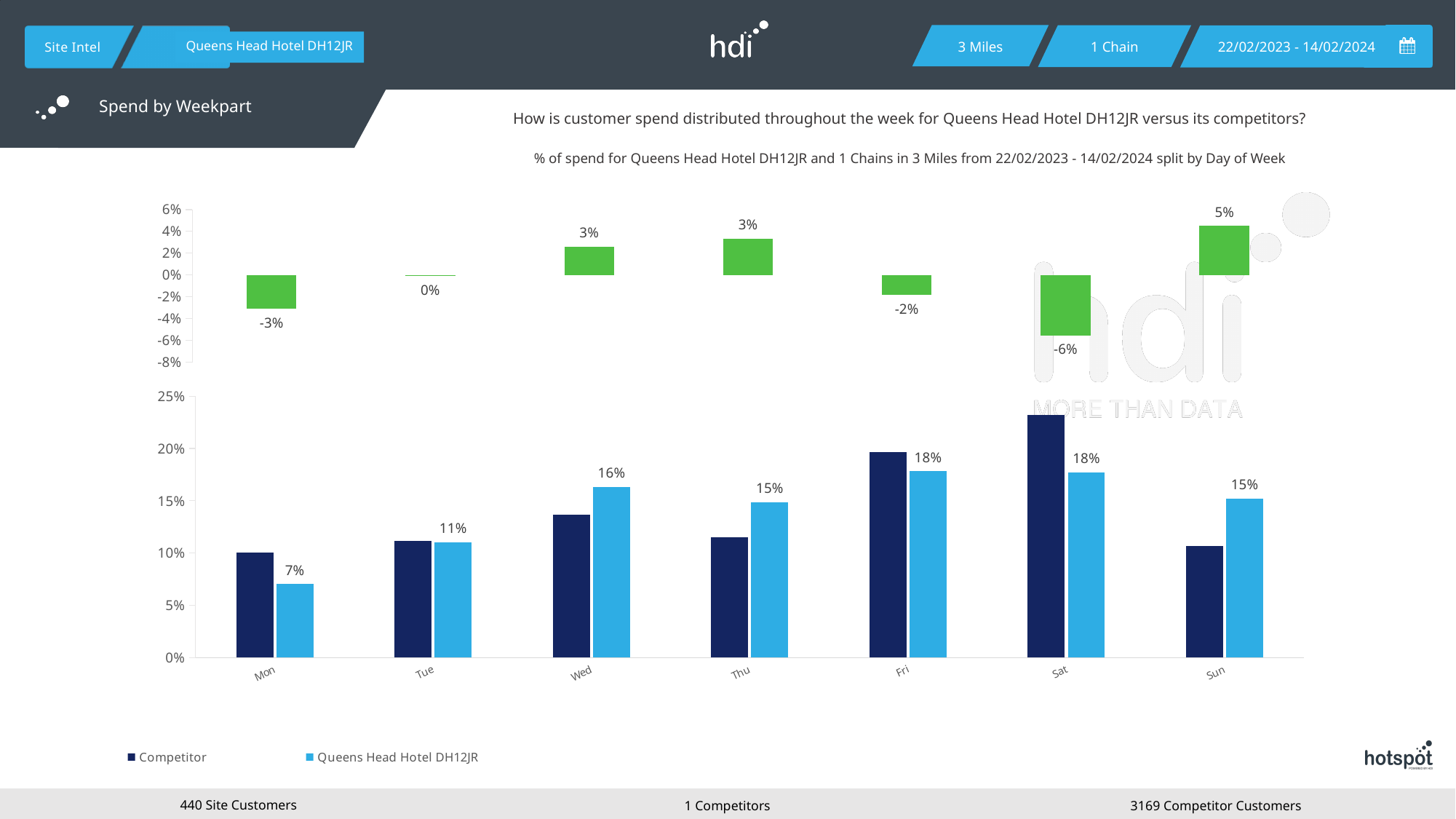
In the top chart, which day has the lowest value? Sat In the top chart, what is the value shown for Sun? 5% In the bottom chart, what is the difference between the Queens Head Hotel DH12JR values for Fri and Mon? 11% In the bottom chart, what is the value for Queens Head Hotel DH12JR on Wed? 16% In the bottom chart, what is the value for Queens Head Hotel DH12JR on Mon? 7% In the bottom chart, which is larger on Sat: the Competitor value or the Queens Head Hotel DH12JR value? Competitor In the top chart, what is the value shown for Sat? -6% In the bottom chart, is the Competitor value for Sat greater or less than 20%? greater In the bottom chart, which day has the lowest value for Queens Head Hotel DH12JR? Mon How many days are shown on the x axis of the bottom chart? 7 In the top chart, which day has the highest value? Sun How many series does the legend of the bottom chart list? 2